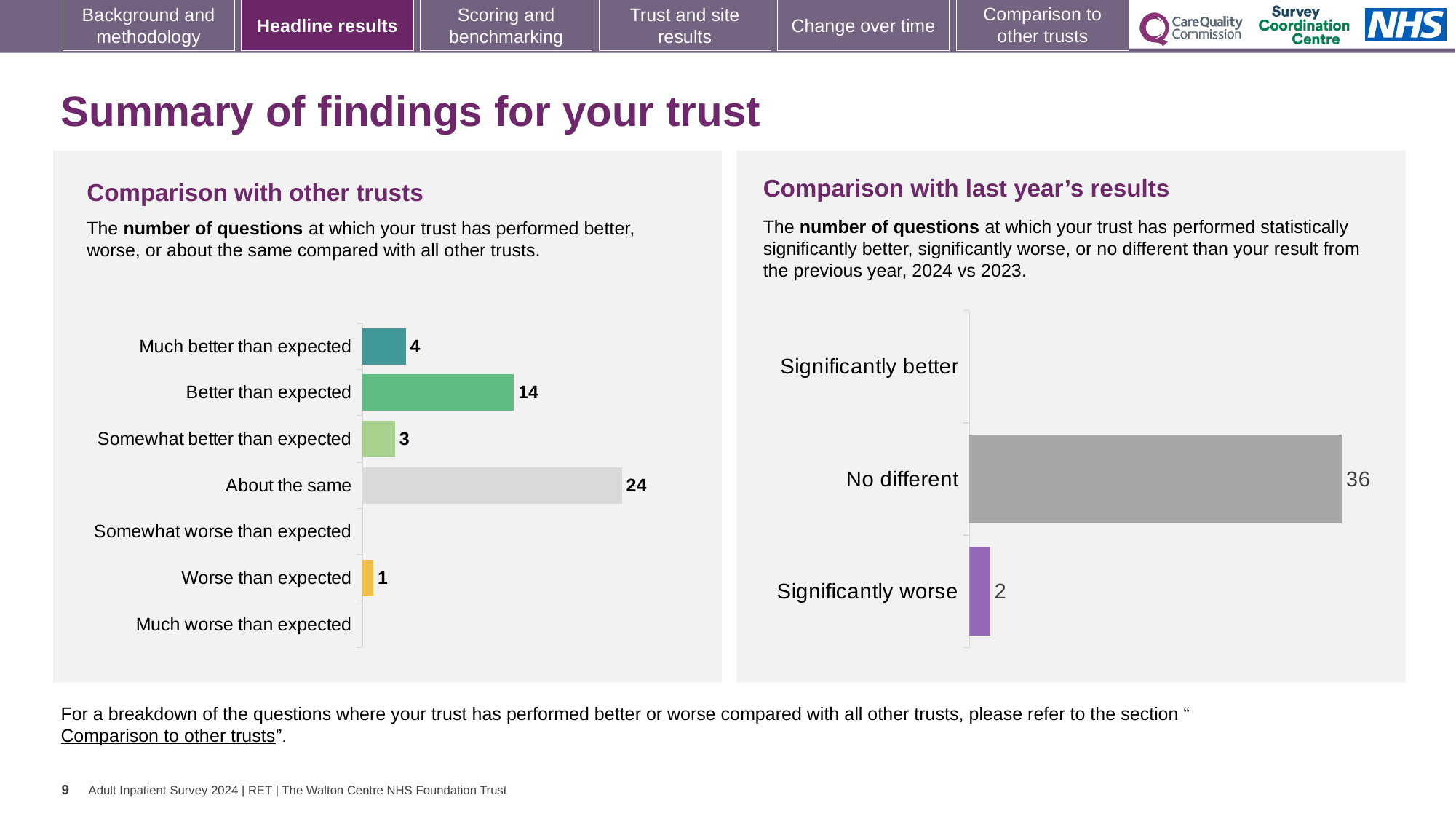
In the 'Comparison with other trusts' chart, what is the value for 'Worse than expected'? 1 In the 'Comparison with last year's results' chart, what is the value for 'Significantly worse'? 2 In the 'Comparison with other trusts' chart, what colour is the 'Worse than expected' bar? Yellow/orange What type of chart is the 'Comparison with last year's results' chart? Bar chart In the 'Comparison with other trusts' chart, what is the difference between 'Better than expected' and 'Much better than expected'? 10 In the 'Comparison with other trusts' chart, what is the value for 'About the same'? 24 In the 'Comparison with last year's results' chart, what is the value for 'No different'? 36 In the 'Comparison with last year's results' chart, what is the difference between 'No different' and 'Significantly worse'? 34 In the 'Comparison with other trusts' chart, which category has the highest value? About the same In the 'Comparison with other trusts' chart, how many questions were 'Better than expected'? 14 How many categories are listed on the y axis of the 'Comparison with other trusts' chart? 7 In the 'Comparison with other trusts' chart, which is larger: 'Much better than expected' or 'Somewhat better than expected'? Much better than expected